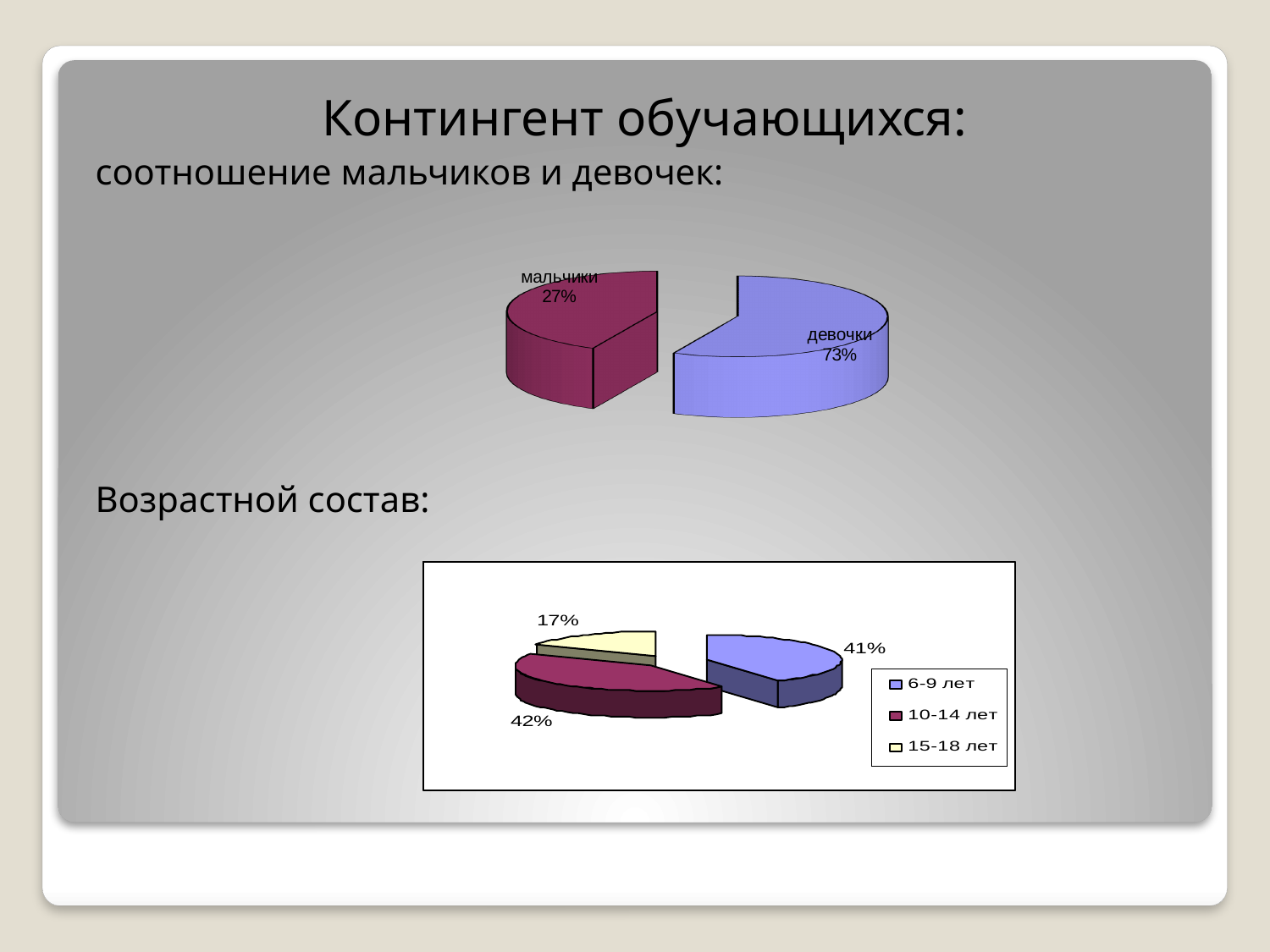
How many entries does the legend of the bottom pie chart (Возрастной состав) list? 3 How many slices does the top pie chart (соотношение мальчиков и девочек) have? 2 In the bottom pie chart (Возрастной состав), what colour represents 15-18 лет in the legend? yellow In the top pie chart (соотношение мальчиков и девочек), what share is labelled for мальчики? 27% What type of chart is used for Возрастной состав? pie chart In the top pie chart (соотношение мальчиков и девочек), which group has the larger share? девочки In the top pie chart (соотношение мальчиков и девочек), what share is labelled for девочки? 73% In the bottom pie chart (Возрастной состав), what share is shown for 15-18 лет? 17% In the bottom pie chart (Возрастной состав), which age group has the smallest share? 15-18 лет In the bottom pie chart (Возрастной состав), what share is shown for 6-9 лет? 41% In the top pie chart (соотношение мальчиков и девочек), by how many percentage points does девочки exceed мальчики? 46% In the bottom pie chart (Возрастной состав), what share is shown for 10-14 лет? 42%